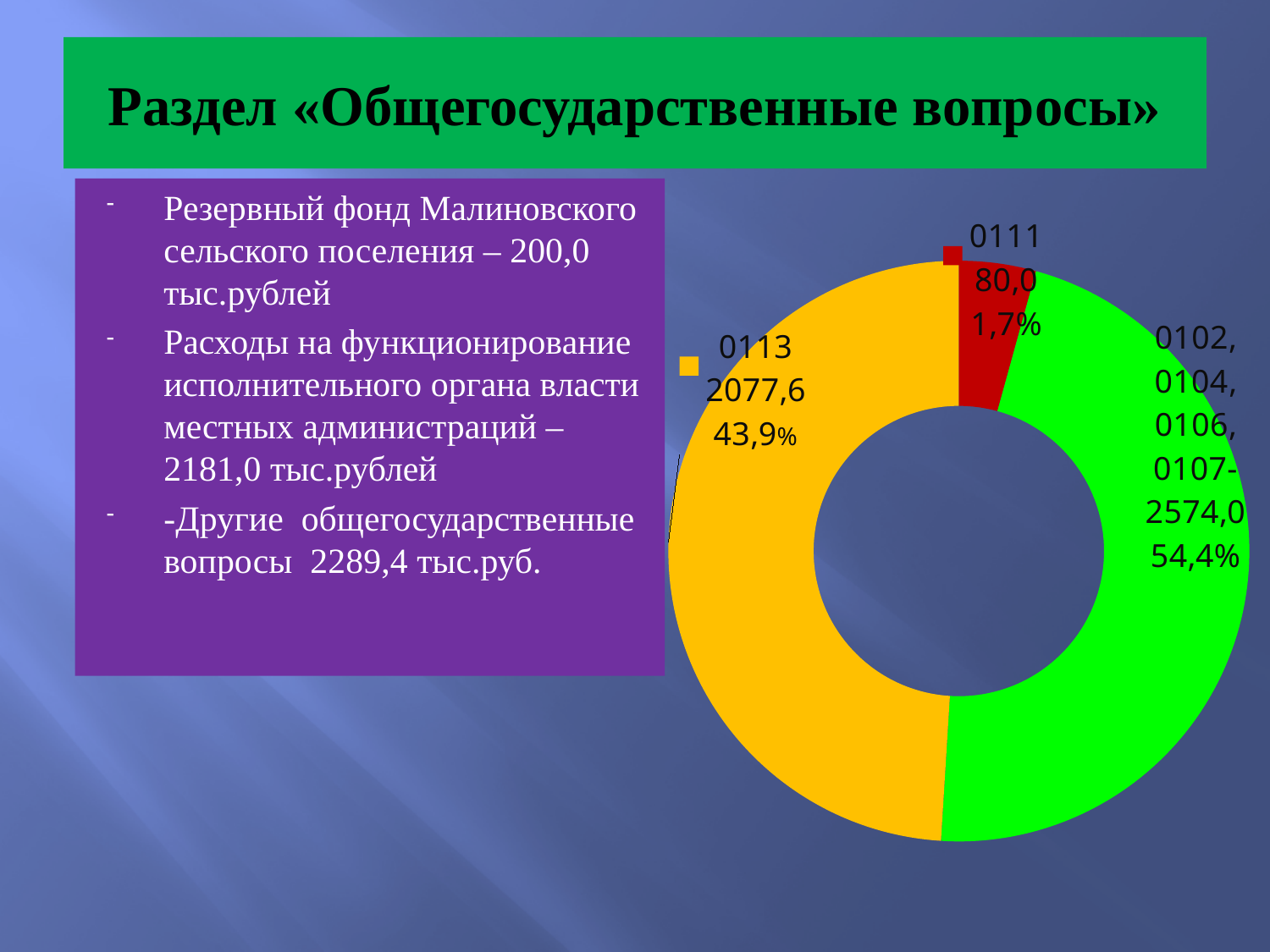
What is the difference between the values of segment 0102, 0104, 0106, 0107- and segment 0113? 496,4 What value is shown for segment 0113? 2077,6 What percentage is shown for segment 0111? 1,7% Which segment has the smallest value? 0111 What percentage share does the segment 0102, 0104, 0106, 0107- have? 54,4% What colour is the segment for 0111? Red Which segment has the largest value? 0102, 0104, 0106, 0107- What percentage share does segment 0113 have? 43,9% What type of chart is shown on the slide? Doughnut chart What value is shown for the segment labelled 0102, 0104, 0106, 0107-? 2574,0 How many segments does the doughnut chart have? 3 Which is larger: the value for 0113 or the value for 0111? 0113